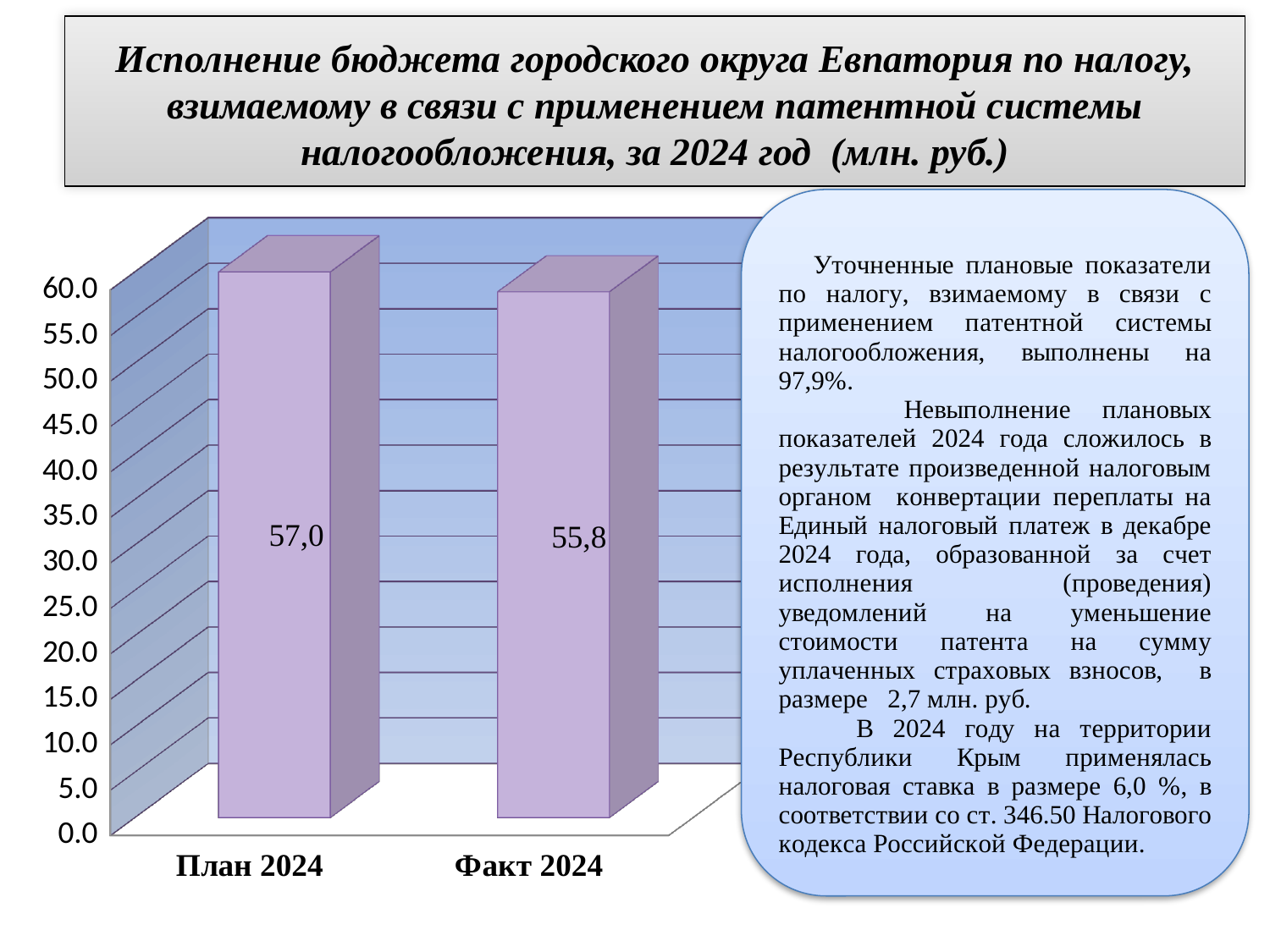
What is the value for План 2024? 57,0 Is the value for Факт 2024 greater or less than 50.0? greater What is the difference between the values for План 2024 and Факт 2024? 1,2 Do the values rise or fall from План 2024 to Факт 2024? fall What is the highest tick value shown on the vertical axis? 60.0 What kind of chart is shown on the slide? bar chart Which category has the lowest value? Факт 2024 Which is larger, the value for План 2024 or the value for Факт 2024? План 2024 What is the value for Факт 2024? 55,8 How many categories are shown on the chart? 2 Which category has the highest value? План 2024